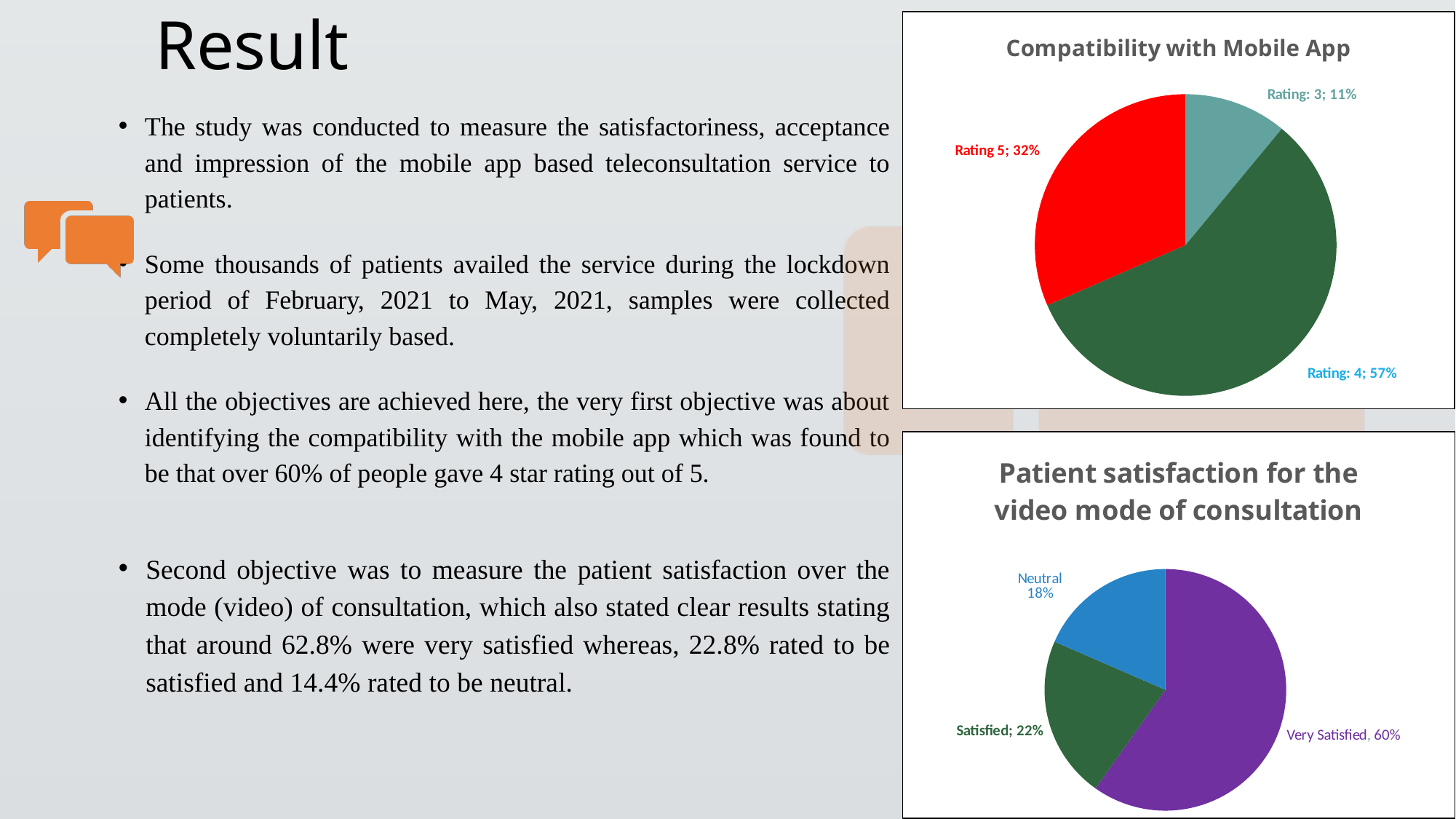
In the 'Patient satisfaction for the video mode of consultation' chart, what share of the pie is Very Satisfied? 60% In the 'Compatibility with Mobile App' chart, what is the difference in percentage points between Rating 4 and Rating 5? 25 In the 'Compatibility with Mobile App' chart, how many slices does the pie have? 3 What kind of chart is 'Patient satisfaction for the video mode of consultation'? Pie chart In the 'Compatibility with Mobile App' chart, which rating has the smallest slice? Rating 3 In the 'Compatibility with Mobile App' chart, what share of the pie is Rating 5? 32% In the 'Patient satisfaction for the video mode of consultation' chart, what colour is the Very Satisfied slice? Purple In the 'Compatibility with Mobile App' chart, what share of the pie is Rating 4? 57% In the 'Patient satisfaction for the video mode of consultation' chart, which is larger, Satisfied or Neutral? Satisfied In the 'Compatibility with Mobile App' chart, which rating has the largest slice? Rating 4